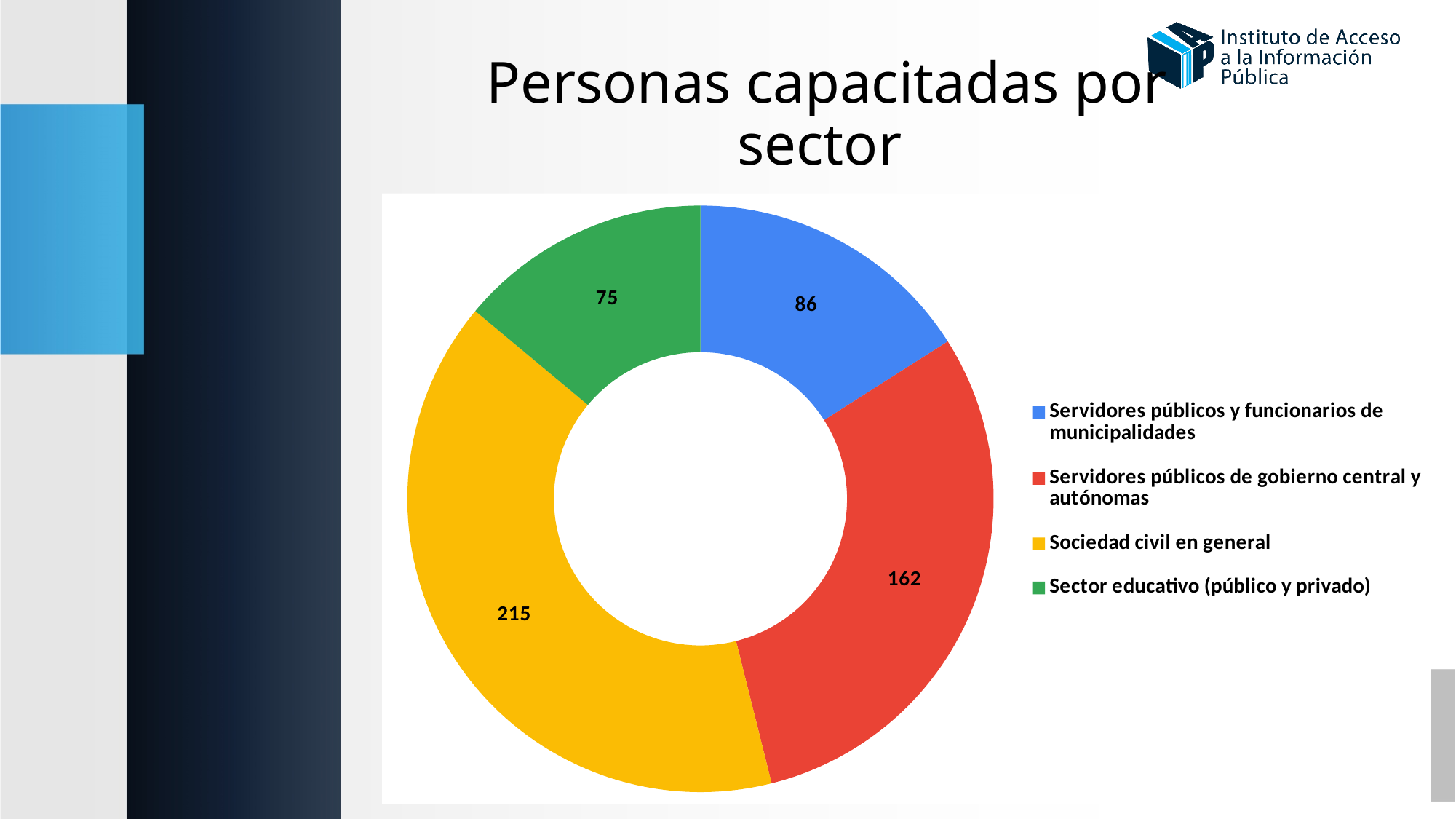
What kind of chart is shown on the slide? doughnut chart What is the total of all four sectors combined? 538 Which sector has the highest number of people trained? Sociedad civil en general What is the value for Sector educativo (público y privado)? 75 What is the title of the chart? Personas capacitadas por sector What is the value for Servidores públicos y funcionarios de municipalidades? 86 Which is larger: Servidores públicos y funcionarios de municipalidades or Sector educativo (público y privado)? Servidores públicos y funcionarios de municipalidades Which sector has the lowest number of people trained? Sector educativo (público y privado) How many sectors are shown in the chart? 4 What is the difference between Sociedad civil en general and Servidores públicos de gobierno central y autónomas? 53 What is the value for Sociedad civil en general? 215 What is the value for Servidores públicos de gobierno central y autónomas? 162